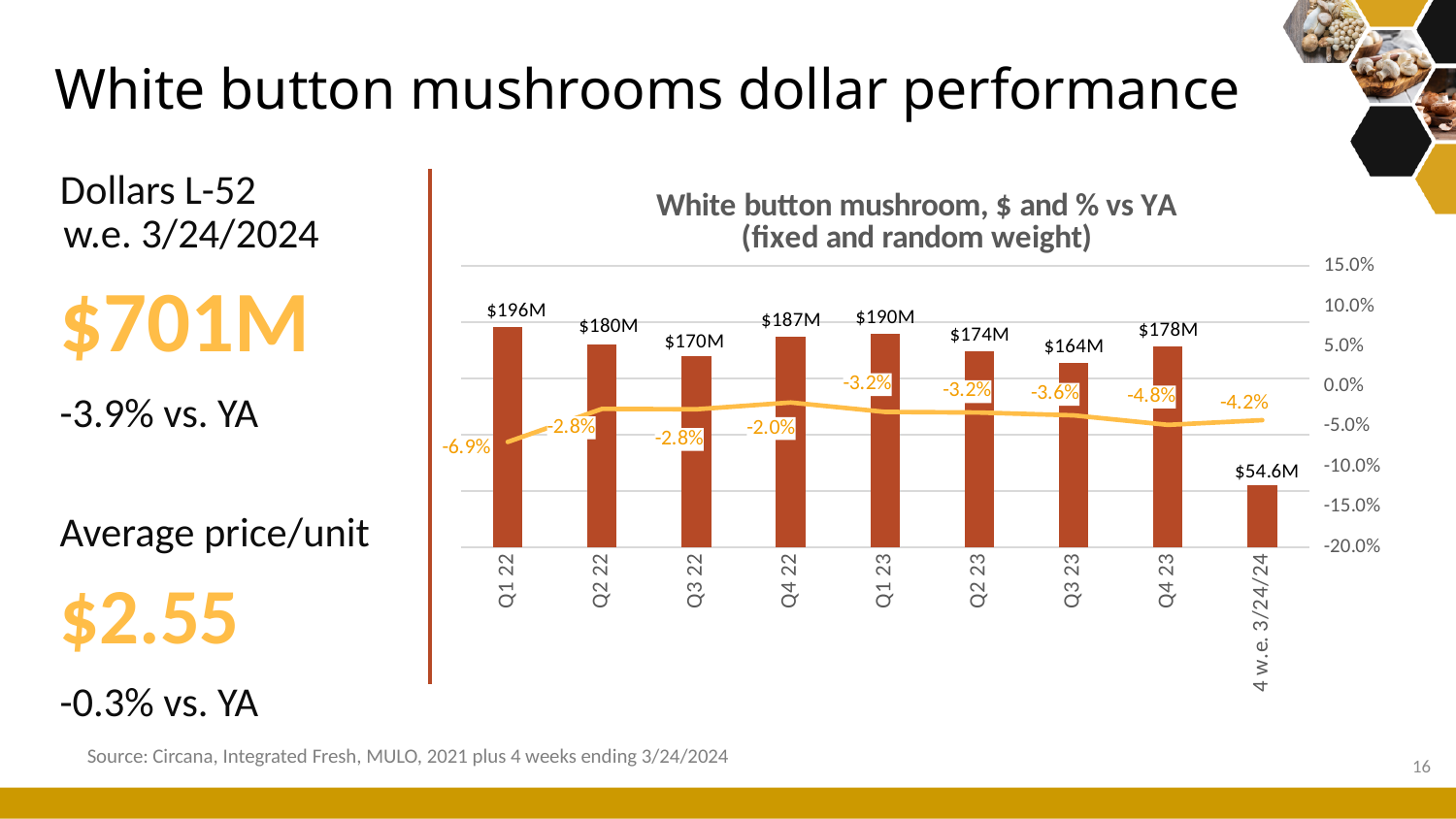
What is the dollar value shown for Q1 22? $196M Which period has the lowest dollar value? 4 w.e. 3/24/24 What is the % vs YA value shown for Q1 22? -6.9% What is the title of the chart? White button mushroom, $ and % vs YA (fixed and random weight) What is the dollar value shown for the 4 w.e. 3/24/24 period? $54.6M Do the dollar values rise or fall from Q1 22 to Q3 22? Fall Which period has the highest dollar value? Q1 22 How many periods are shown on the x axis? 9 Which has the larger dollar value, Q4 22 or Q2 23? Q4 22 What is the difference in dollar value between Q1 23 and Q3 23? $26M What is the % vs YA value shown for Q4 23? -4.8% What kind of chart is this? Combined bar and line chart